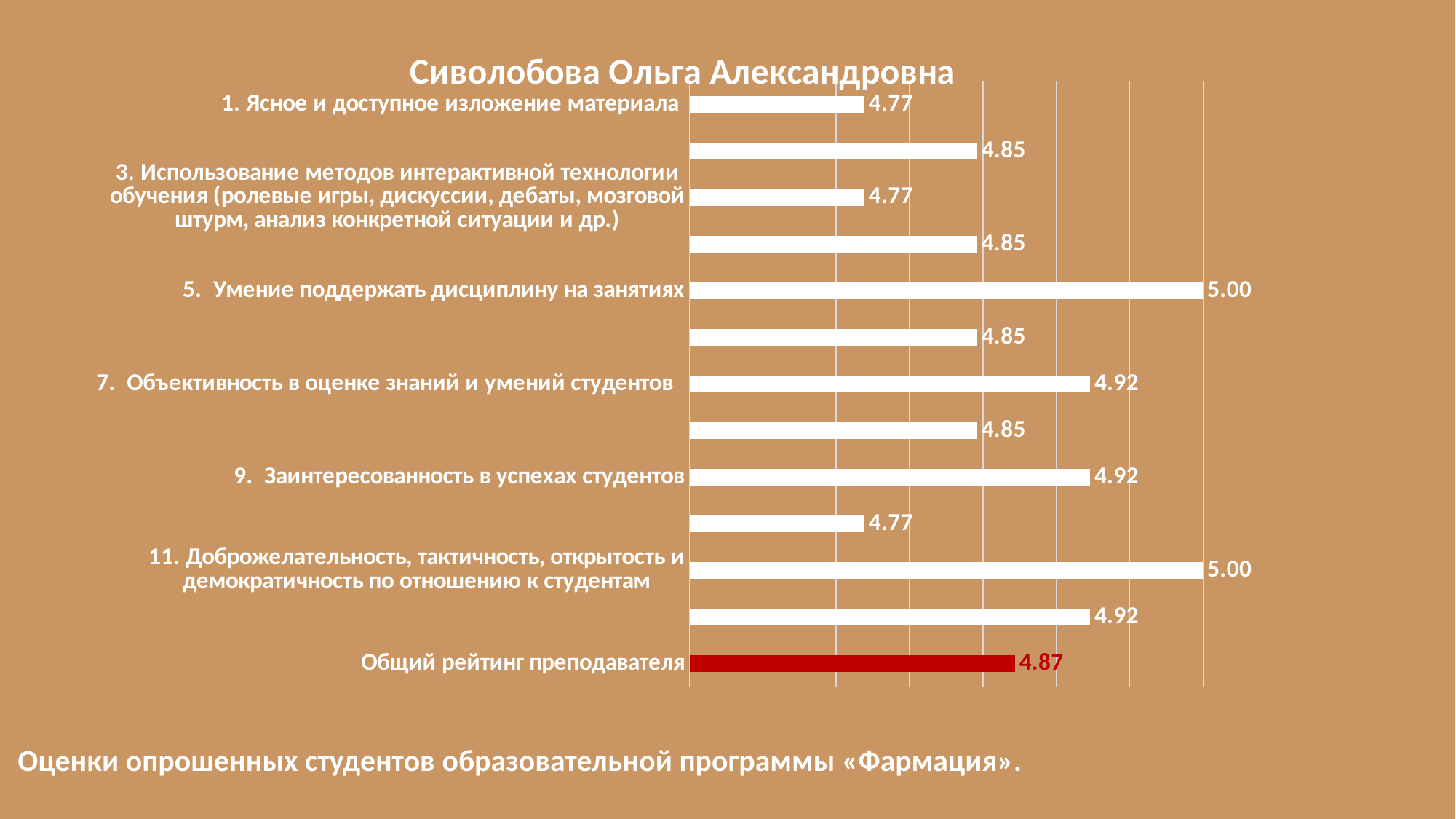
What is the highest value shown on the chart? 5.00 What is the value for "5. Умение поддержать дисциплину на занятиях"? 5.00 What is the value for "Общий рейтинг преподавателя"? 4.87 What is the value for "9. Заинтересованность в успехах студентов"? 4.92 What kind of chart is shown on the slide? Bar chart What is the value for "7. Объективность в оценке знаний и умений студентов"? 4.92 What is the value for "1. Ясное и доступное изложение материала"? 4.77 How many bars are plotted on the chart? 13 What is the title of the chart? Сиволобова Ольга Александровна What is the value for "11. Доброжелательность, тактичность, открытость и демократичность по отношению к студентам"? 5.00 Which has a larger value: "7. Объективность в оценке знаний и умений студентов" or "1. Ясное и доступное изложение материала"? 7. Объективность в оценке знаний и умений студентов What is the difference between the values for "5. Умение поддержать дисциплину на занятиях" and "1. Ясное и доступное изложение материала"? 0.23